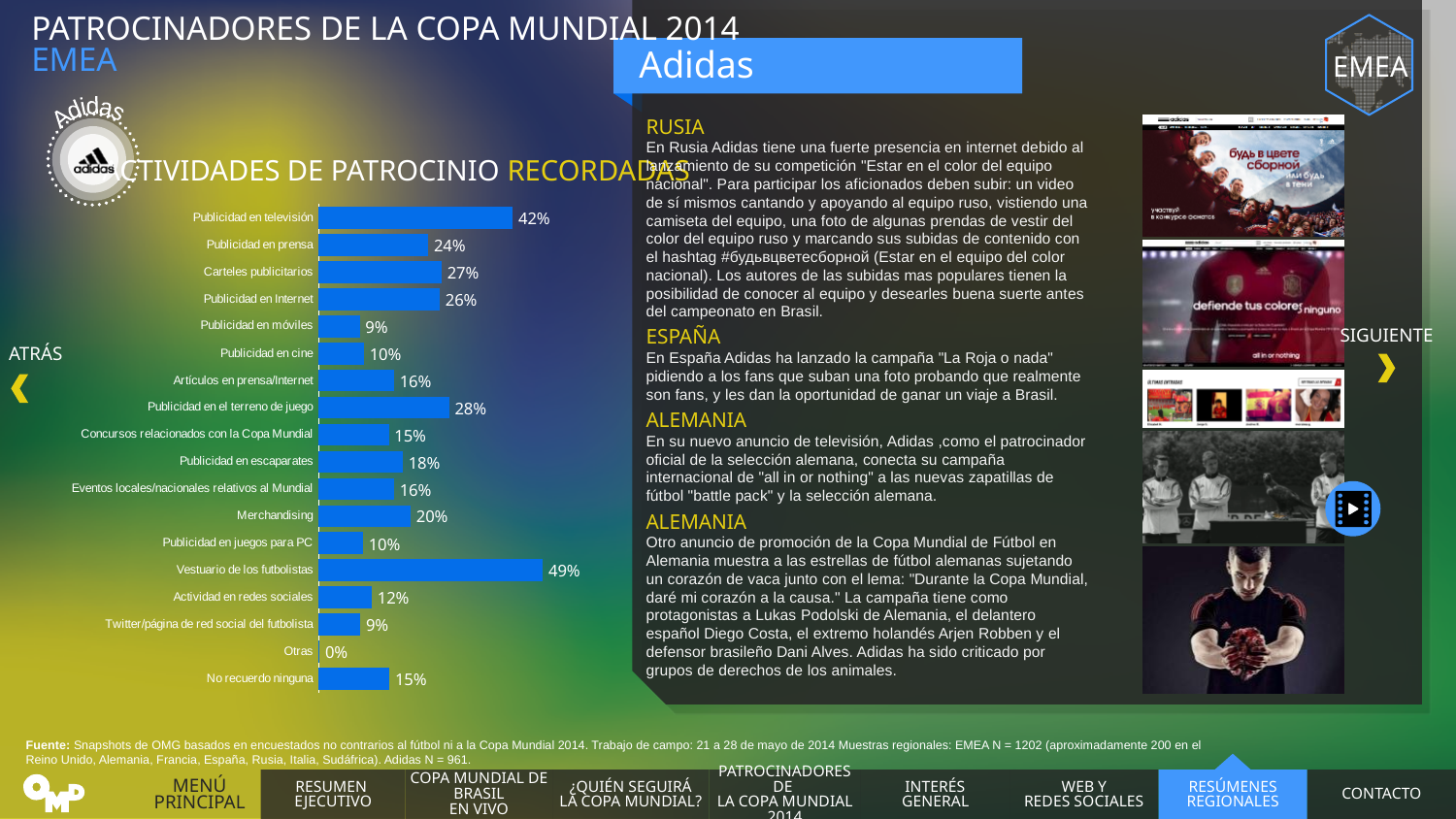
What is the value for Publicidad en televisión? 42% What is the value for No recuerdo ninguna? 15% Which category has the lowest value? Otras What type of chart is shown on the slide? Bar chart What is the difference between Publicidad en el terreno de juego and Publicidad en escaparates? 10% What is the difference between Vestuario de los futbolistas and Publicidad en televisión? 7% Which category has the highest value? Vestuario de los futbolistas What is the value for Vestuario de los futbolistas? 49% How many categories are shown in the chart? 18 Which is larger, Carteles publicitarios or Publicidad en Internet? Carteles publicitarios What is the value for Merchandising? 20% What is the value for Actividad en redes sociales? 12%